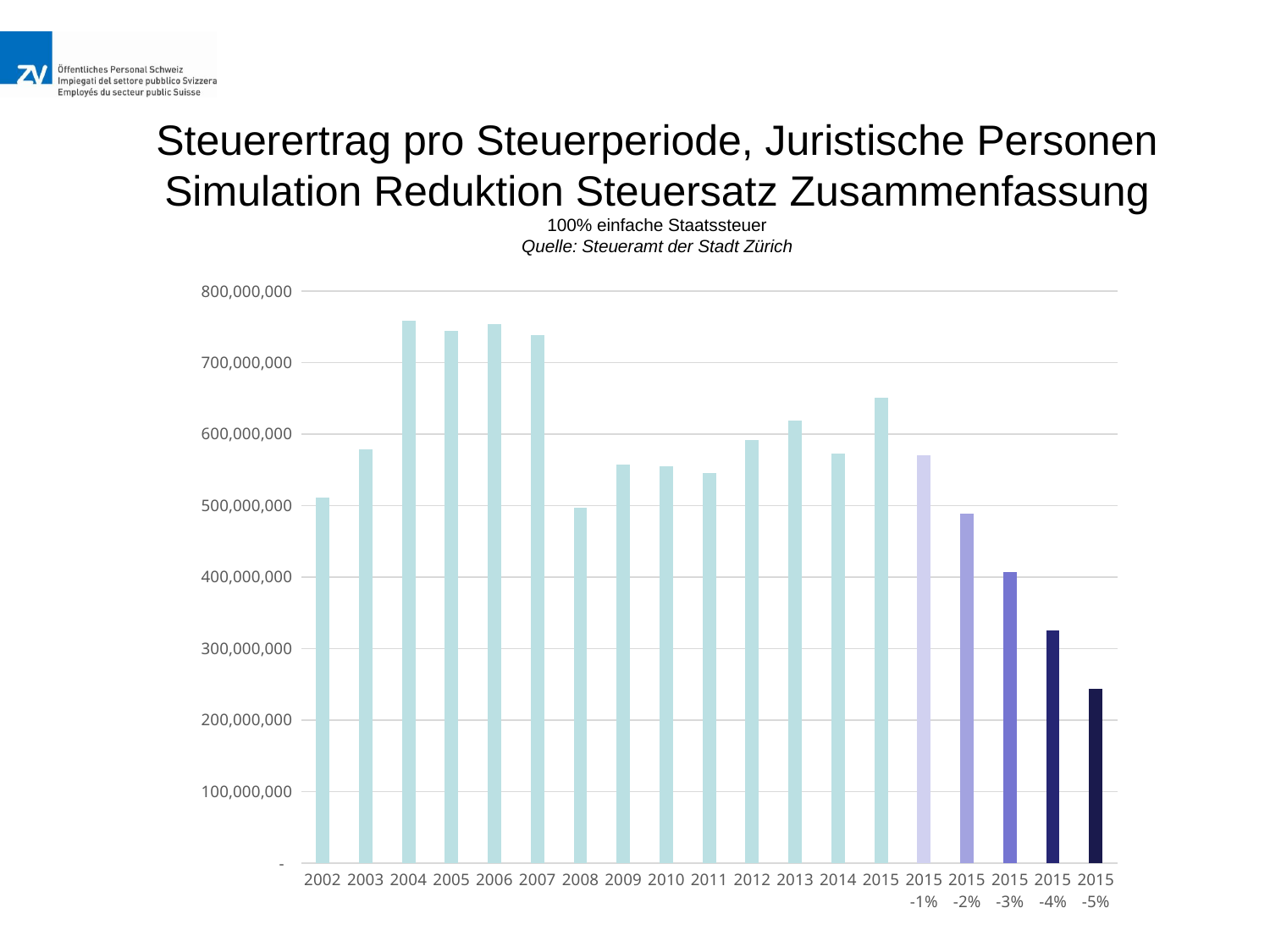
How many bars are plotted in the chart? 19 Do the values rise or fall across the simulation bars from 2015 -1% to 2015 -5%? fall Which is larger, the value for 2015 or the value for 2014? 2015 What source is cited below the chart title? Steueramt der Stadt Zürich Is the value for 2004 greater or less than 700,000,000? greater Is the value for 2015 -5% greater or less than 300,000,000? less Is the value for 2015 -3% greater or less than 400,000,000? greater Which bar has the lowest value in the chart? 2015 -5% Which is larger, the value for 2004 or the value for 2008? 2004 What kind of chart is shown on the slide? bar chart